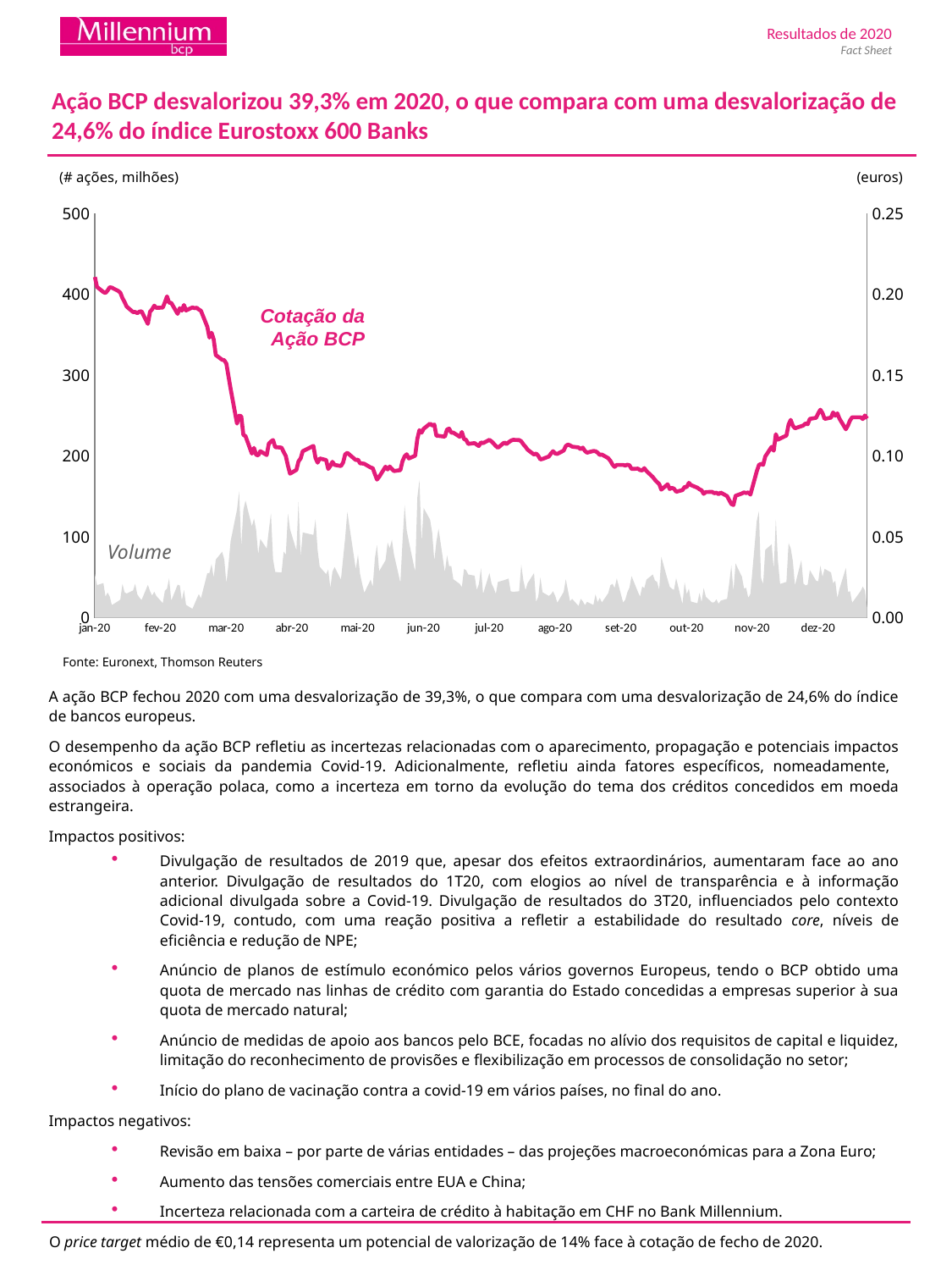
Is the lowest point of the Cotação da Ação BCP line, around nov-20, greater or less than 0.10 euros? less Is the Cotação da Ação BCP at the end of dez-20 greater or less than 0.10 euros? greater How many month labels are shown along the x axis of the chart? 12 What is the maximum value shown on the right-hand (euros) axis of the chart? 0.25 Is the Cotação da Ação BCP at the start of jan-20 greater or less than 0.15 euros? greater What kind of chart is used to show the Cotação da Ação BCP on the slide? line chart Does the Cotação da Ação BCP line rise or fall between nov-20 and dez-20? rise How many data series are shown on the chart? 2 Does the Cotação da Ação BCP line rise or fall between jan-20 and mar-20? fall Which is higher on the chart: the Cotação da Ação BCP at the start of jan-20 or at the end of dez-20? jan-20 What unit label is shown above the left-hand axis of the chart? (# ações, milhões)